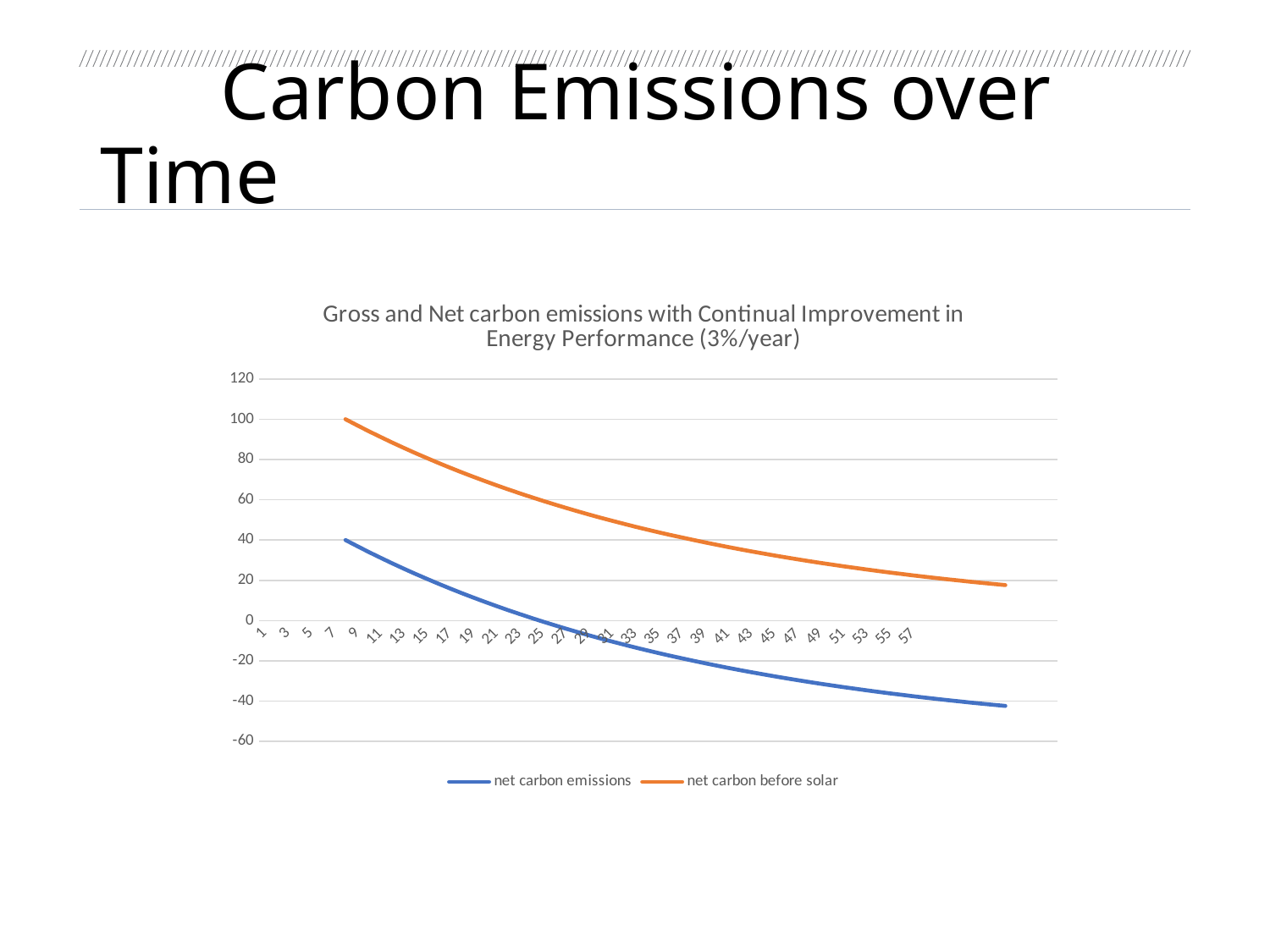
Which colour is used for the 'net carbon before solar' series? orange What kind of chart is shown on the slide? line chart What is the starting value of the 'net carbon before solar' line? 100 Do the values of the 'net carbon emissions' series rise or fall along the x axis? fall Is the final value of the 'net carbon emissions' line greater or less than -20? less How many series does the legend list? 2 Which series has the higher starting value, 'net carbon emissions' or 'net carbon before solar'? net carbon before solar Is the final value of the 'net carbon before solar' line greater or less than 0? greater What is the title of the chart? Gross and Net carbon emissions with Continual Improvement in Energy Performance (3%/year) What is the starting value of the 'net carbon emissions' line? 40 Do the values of the 'net carbon before solar' series rise or fall along the x axis? fall